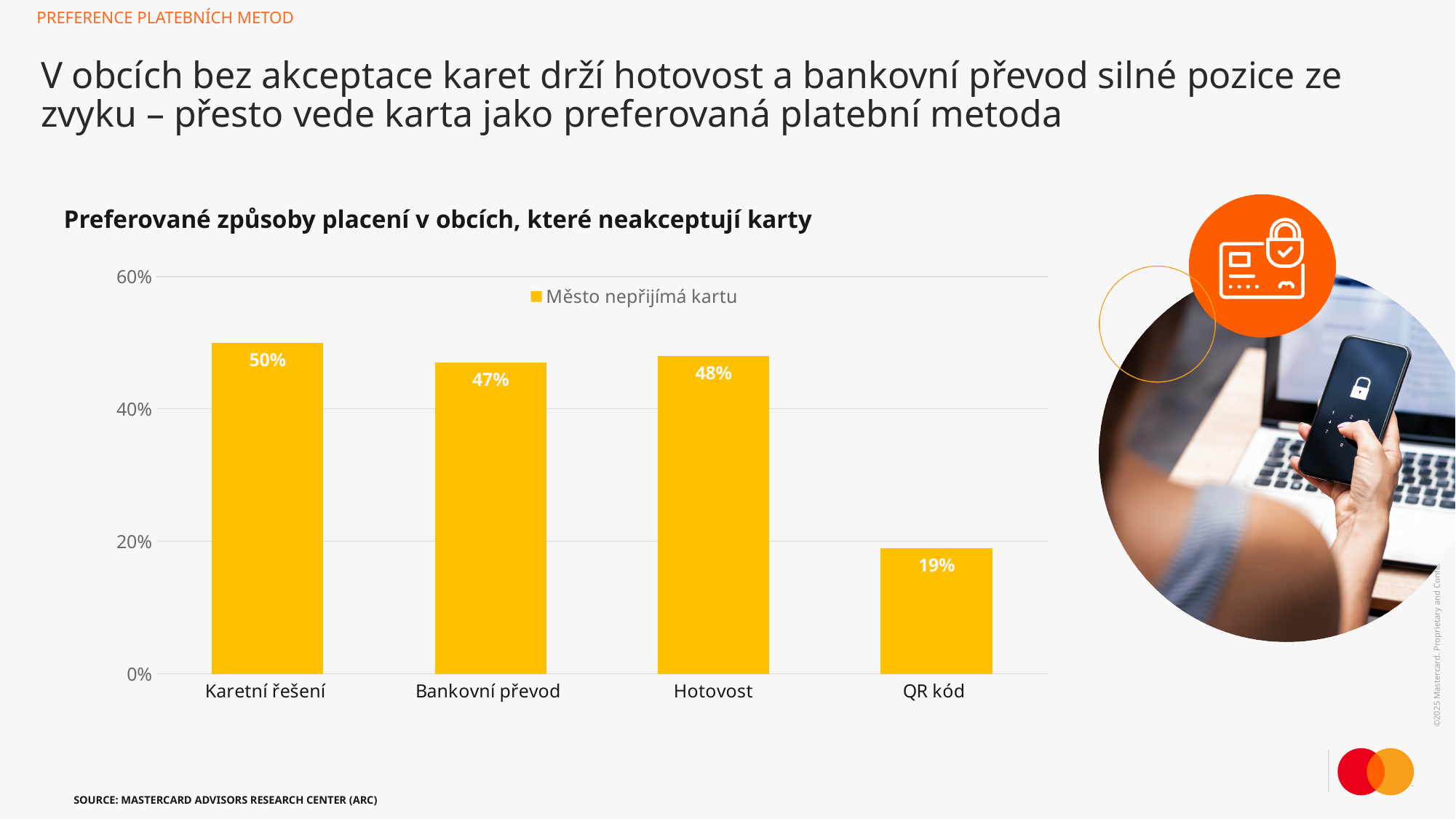
What is the difference between the values for Karetní řešení and QR kód? 31% What is the value for QR kód? 19% What is the value for Bankovní převod? 47% What is the value for Hotovost? 48% Which is larger, the value for Karetní řešení or the value for QR kód? Karetní řešení What series name does the legend show? Město nepřijímá kartu Which category has the highest value? Karetní řešení What is the value for Karetní řešení? 50% What is the difference between the values for Hotovost and Bankovní převod? 1% How many categories are shown on the x axis? 4 Which category has the lowest value? QR kód What kind of chart is shown on the slide? Bar chart